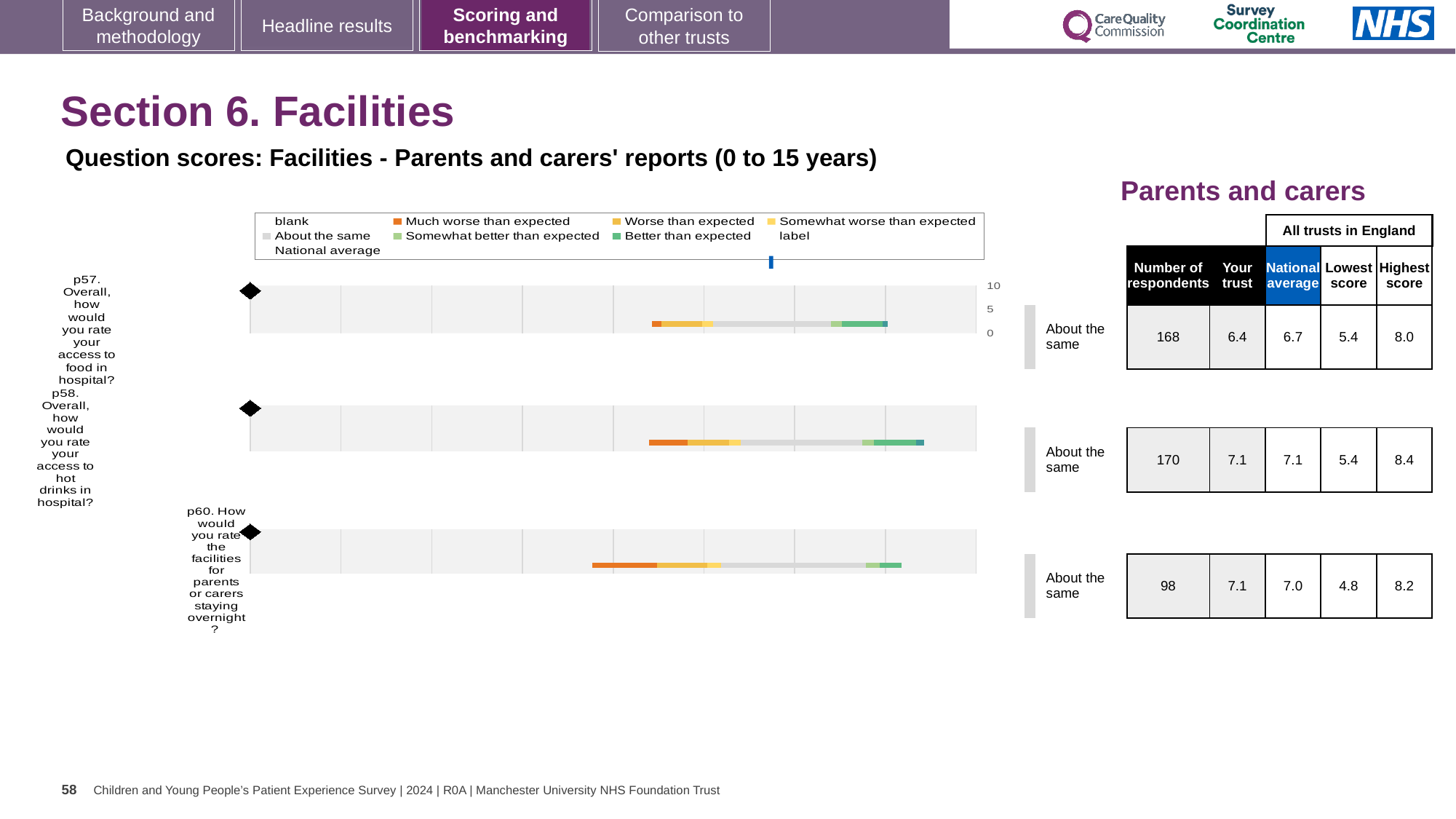
What is the maximum value shown on the score axis of the p57 chart? 10 How many respondents answered p60 (facilities for parents or carers staying overnight)? 98 What is the highest score across all trusts in England for p58 (access to hot drinks in hospital)? 8.4 What is the national average score for p57 (access to food in hospital)? 6.7 Which question has the lowest 'Lowest score' across all trusts in England? p60 (facilities for parents or carers staying overnight) What is the 'Your trust' score for p58 (access to hot drinks in hospital)? 7.1 How many question charts are shown on the slide? 3 For p57 (access to food in hospital), which is larger: the 'Your trust' score or the national average? National average What is the 'Your trust' score for p57 (access to food in hospital)? 6.4 What kind of chart is used to show the benchmarking results for p57 (access to food in hospital)? bar chart What colour represents 'Much worse than expected' in the chart legend? orange What is the difference between the highest score and the lowest score for p57 (access to food in hospital)? 2.6